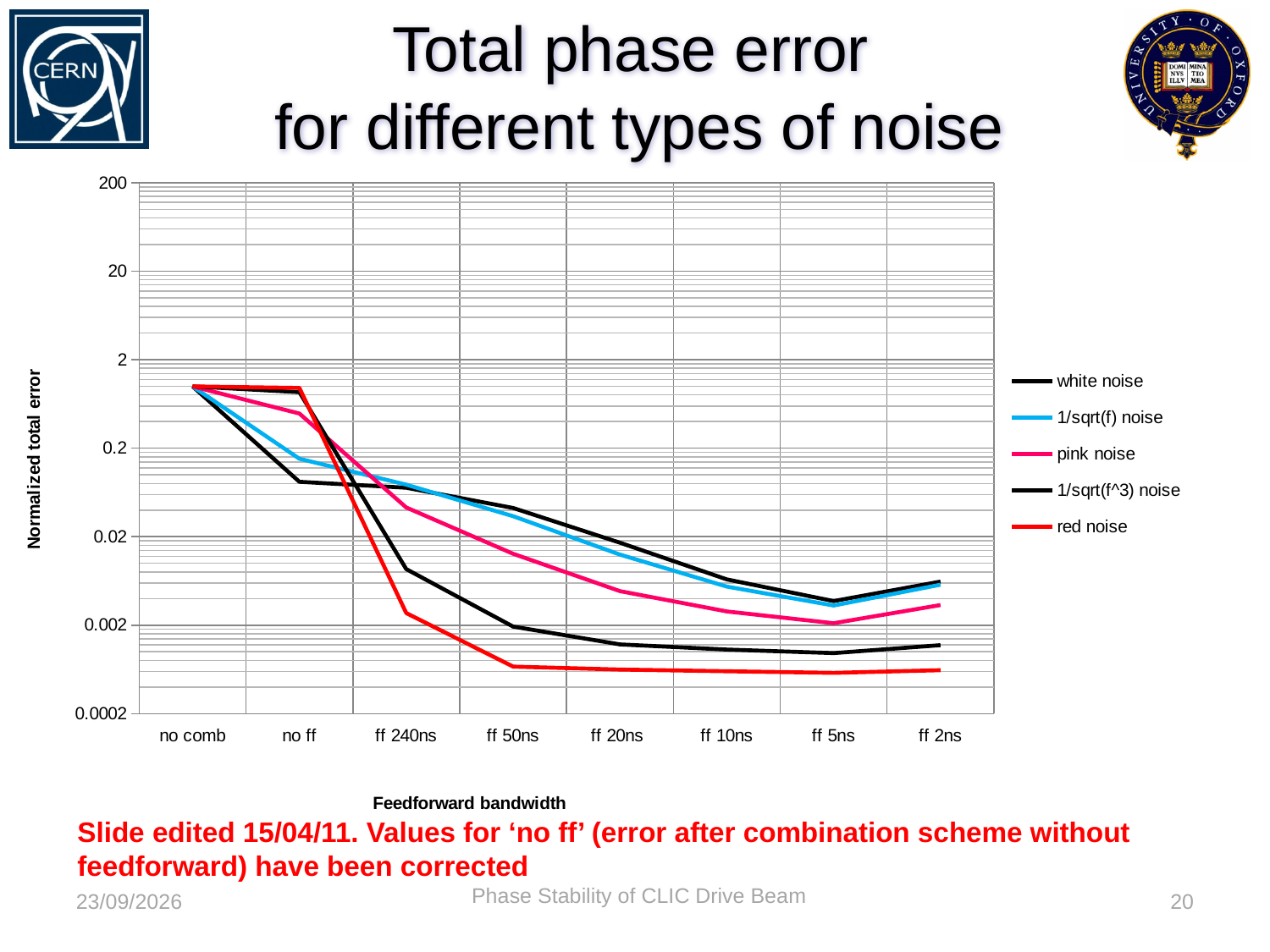
Is the value for white noise at ff 5ns greater or less than 0.002? greater Is the value for pink noise at no comb greater or less than 0.2? greater Is the value for red noise at ff 2ns greater or less than 0.002? less Does the red noise series generally rise or fall from no comb to ff 2ns? fall Which series has the lowest value at ff 240ns? red noise How many series does the legend list? 5 How many categories are shown along the x axis? 8 What kind of chart is shown on the slide? line chart Which series has the lowest value at ff 2ns? red noise At ff 50ns, which is larger: white noise or red noise? white noise